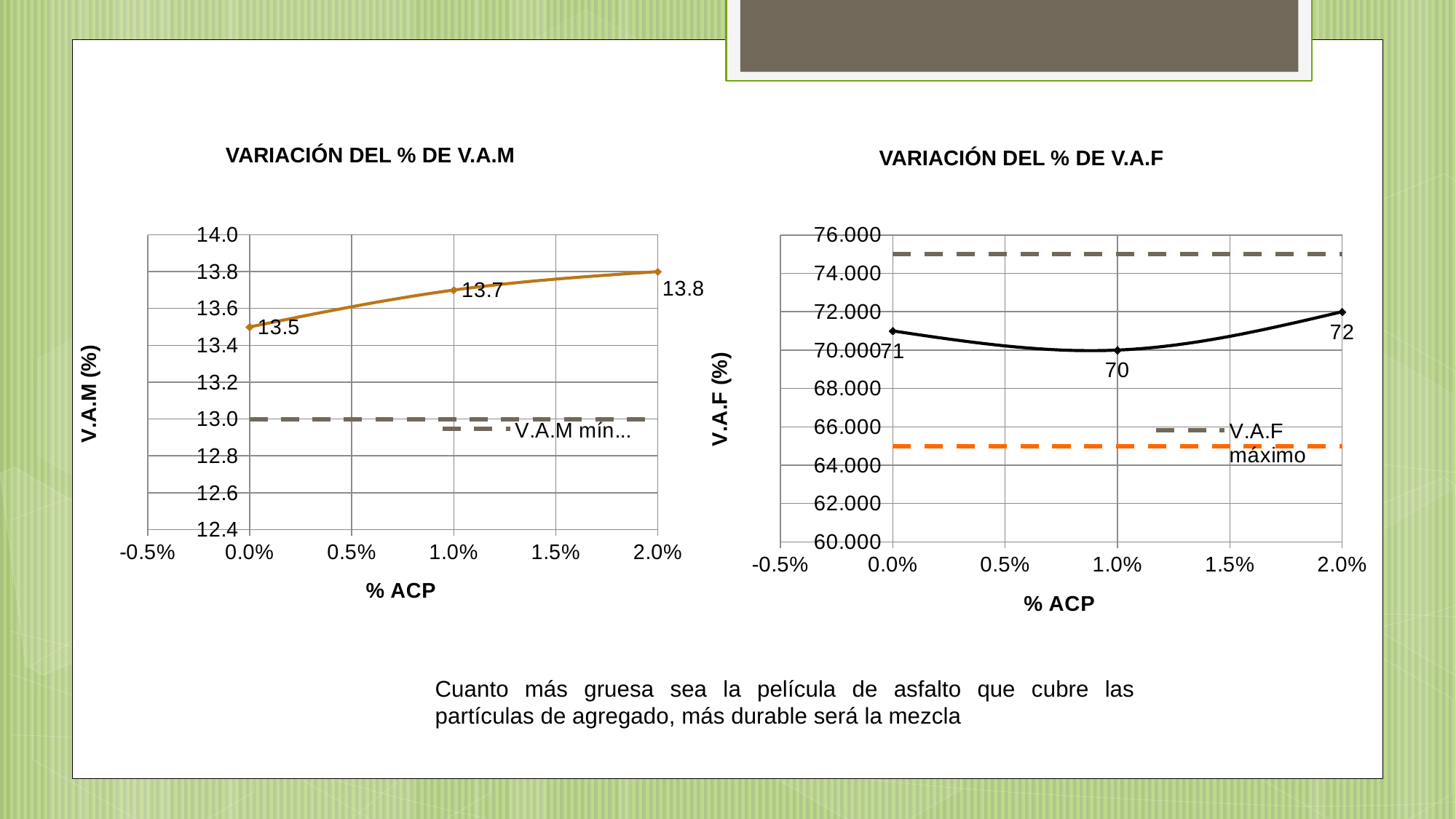
In the chart titled VARIACIÓN DEL % DE V.A.M, what is the V.A.M value at 1.0% ACP? 13.7 In the chart titled VARIACIÓN DEL % DE V.A.M, how many labelled data points are plotted on the V.A.M line? 3 In the chart titled VARIACIÓN DEL % DE V.A.F, which is larger, the V.A.F value at 0.0% ACP or at 2.0% ACP? 2.0% ACP In the chart titled VARIACIÓN DEL % DE V.A.F, what is the V.A.F value at 2.0% ACP? 72 In the chart titled VARIACIÓN DEL % DE V.A.F, at which % ACP is the V.A.F value lowest? 1.0% In the chart titled VARIACIÓN DEL % DE V.A.M, what is the V.A.M value at 0.0% ACP? 13.5 In the chart titled VARIACIÓN DEL % DE V.A.M, at which % ACP is the V.A.M value highest? 2.0% In the chart titled VARIACIÓN DEL % DE V.A.M, what is the difference between the V.A.M values at 2.0% ACP and 0.0% ACP? 0.3 In the chart titled VARIACIÓN DEL % DE V.A.F, what is the V.A.F value at 1.0% ACP? 70 In the chart titled VARIACIÓN DEL % DE V.A.M, do the V.A.M values rise or fall as % ACP increases? rise What is the x-axis title of the chart titled VARIACIÓN DEL % DE V.A.F? % ACP In the chart titled VARIACIÓN DEL % DE V.A.F, is the V.A.F value at 0.0% ACP greater or less than 74.000? less